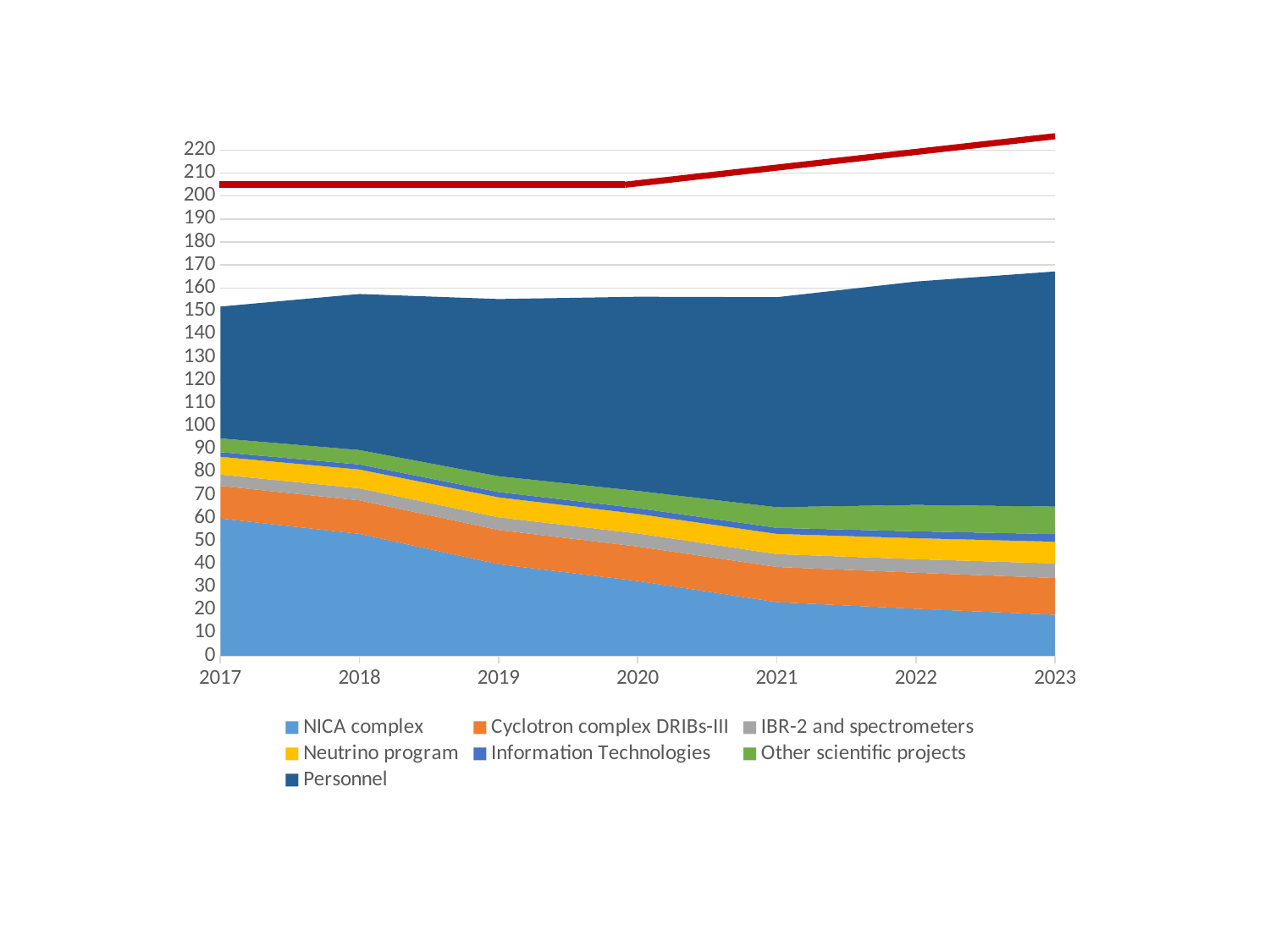
How many years are shown along the x axis? 7 Is the total height of the stacked areas in 2023 greater or less than 160? greater Is the value for NICA complex in 2023 greater or less than 20? less How many series does the legend list? 7 Which is larger, the NICA complex value in 2017 or in 2023? 2017 Which series occupies the largest band in 2023? Personnel Which colour represents Personnel in the legend? Dark blue Is the value for NICA complex in 2017 greater or less than 50? greater What kind of chart is shown on the slide? Stacked area chart Does the NICA complex area rise or fall from 2017 to 2023? Falls